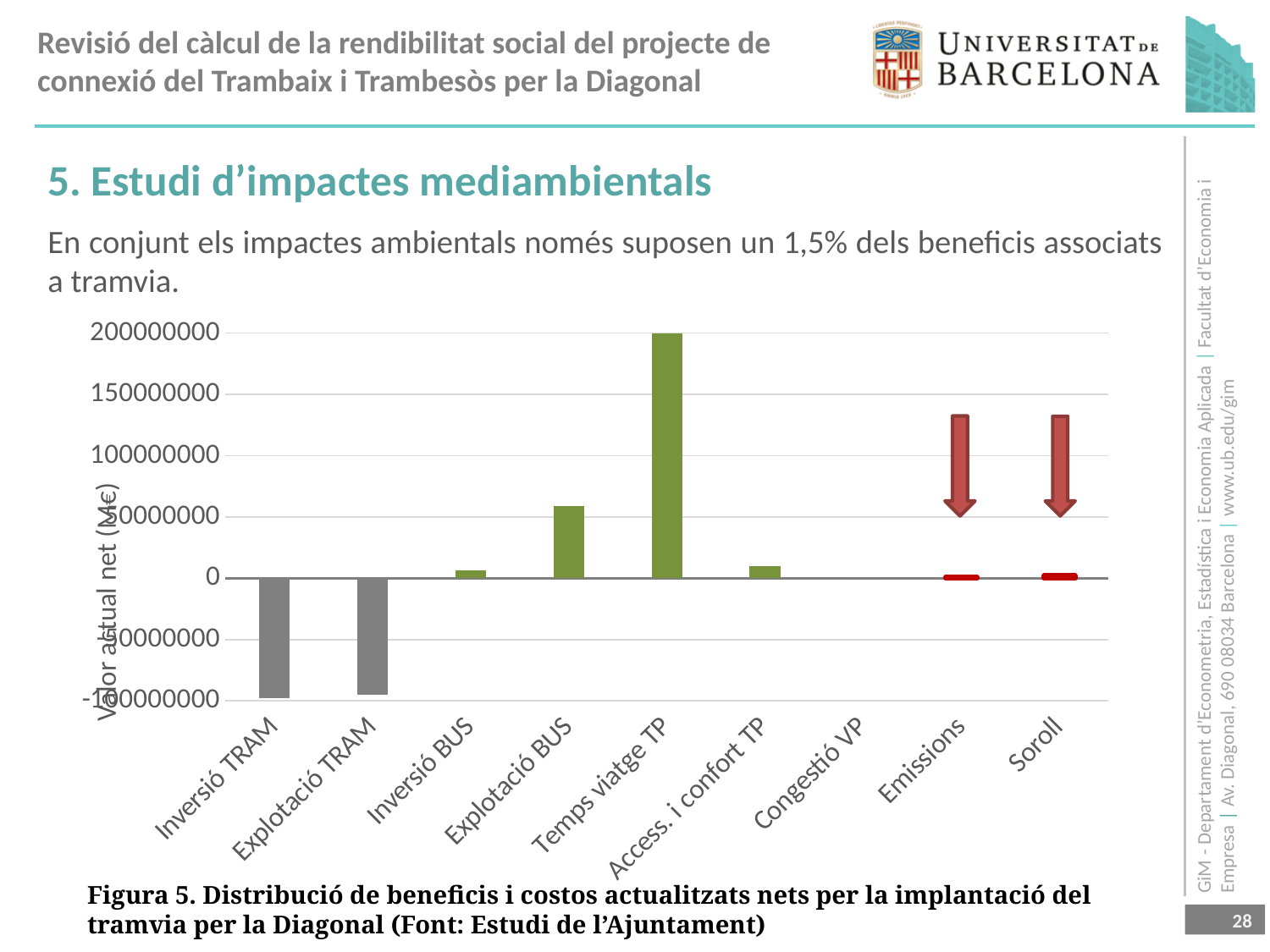
Which is larger, the value for Explotació BUS or the value for Congestió VP? Explotació BUS Is the value for Explotació BUS greater or less than 50000000? greater Is the value for Inversió TRAM greater or less than -50000000? less Which category has the highest value in the chart? Temps viatge TP Which is larger, the value for Congestió VP or the value for Inversió BUS? Inversió BUS How many categories are shown on the x axis of the chart? 9 Is the value for Temps viatge TP greater or less than 150000000? greater What is the title of the vertical axis of the chart? Valor actual net (M€) Which two categories in the chart are marked with red arrows? Emissions and Soroll What kind of chart is shown on the slide? bar chart Which is larger, the value for Temps viatge TP or the value for Explotació BUS? Temps viatge TP